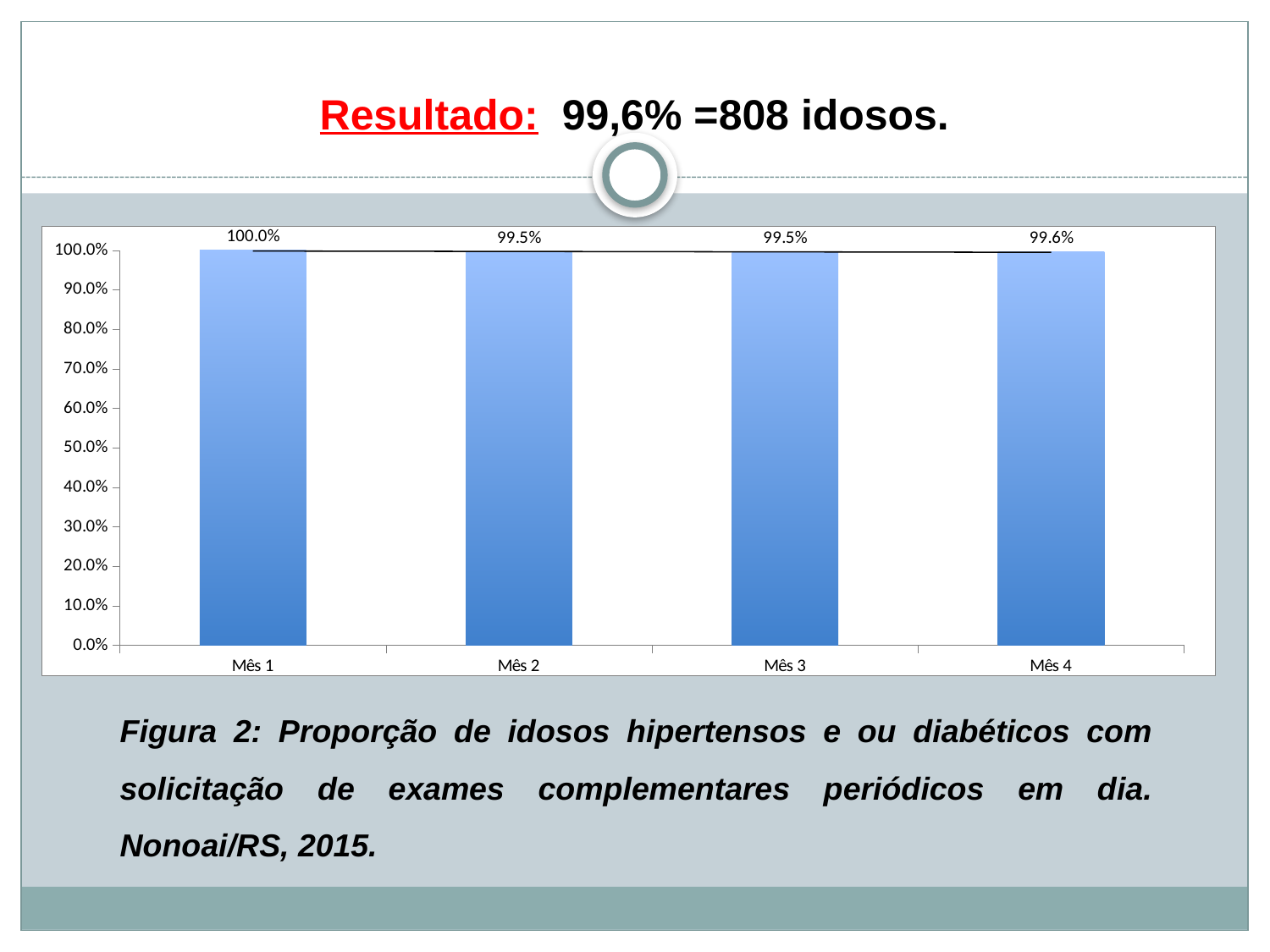
Which is larger, the value for Mês 4 or the value for Mês 3? Mês 4 Which month has the highest value? Mês 1 What is the difference between the values for Mês 1 and Mês 2? 0.5% How many months are shown on the x axis? 4 What is the value for Mês 4? 99.6% Which is larger, the value for Mês 1 or the value for Mês 4? Mês 1 What is the value for Mês 1? 100.0% What kind of chart is shown on the slide? bar chart What is the difference between the values for Mês 1 and Mês 4? 0.4% What is the value for Mês 2? 99.5% Is the value for Mês 3 greater or less than 90.0%? greater What is the figure number given in the caption below the chart? Figura 2